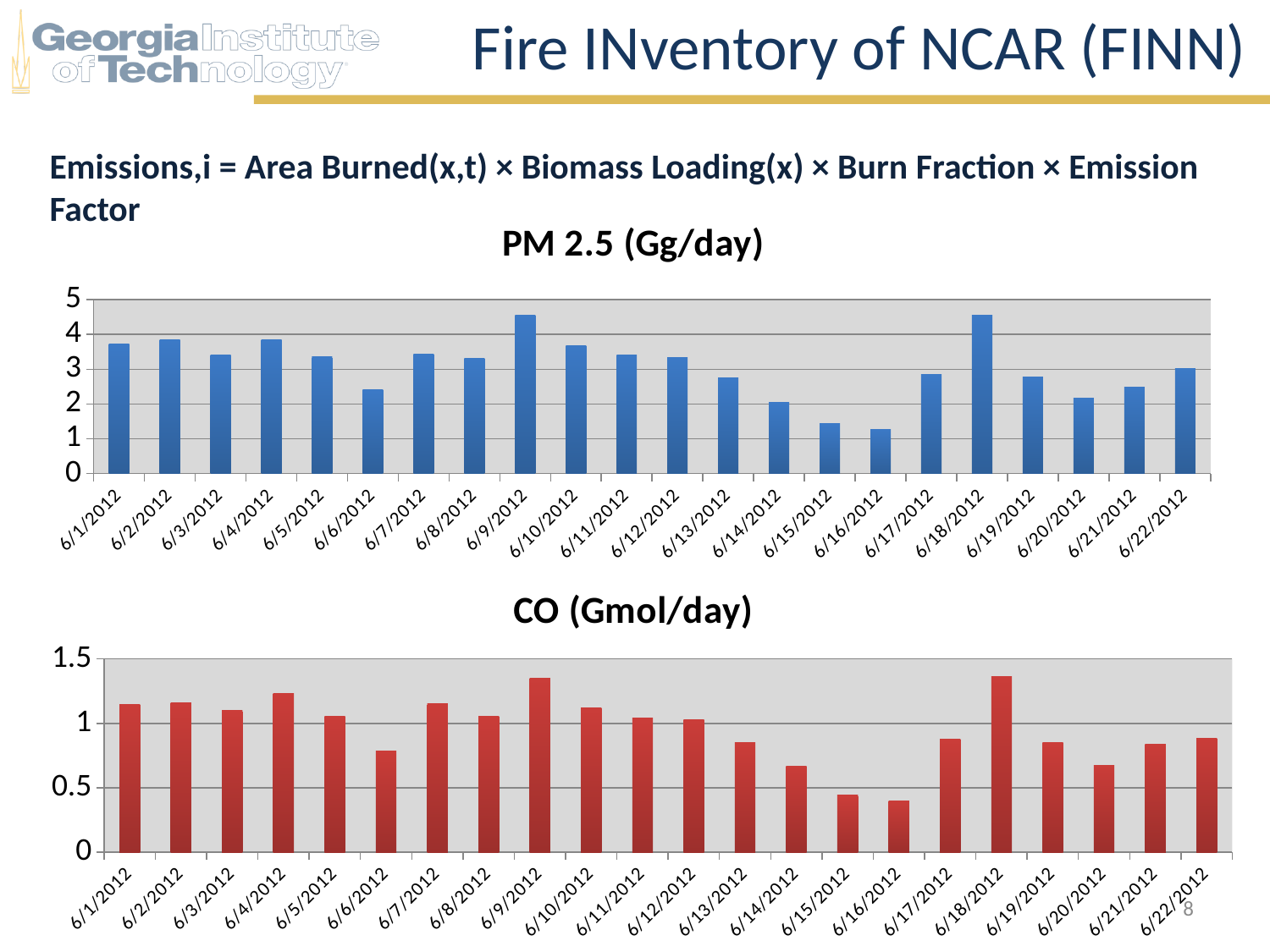
In the CO (Gmol/day) chart, do the values rise or fall from 6/9/2012 to 6/16/2012? fall In the PM 2.5 (Gg/day) chart, what kind of chart is used? bar chart In the CO (Gmol/day) chart, which is larger, the value for 6/1/2012 or the value for 6/16/2012? 6/1/2012 In the CO (Gmol/day) chart, how many dates are plotted along the x axis? 22 In the PM 2.5 (Gg/day) chart, is the value for 6/13/2012 greater or less than 3? less In the PM 2.5 (Gg/day) chart, which date has the lowest value? 6/16/2012 What colour are the bars in the CO (Gmol/day) chart? red In the PM 2.5 (Gg/day) chart, is the value for 6/9/2012 greater or less than 4? greater In the PM 2.5 (Gg/day) chart, is the value for 6/16/2012 greater or less than 2? less In the PM 2.5 (Gg/day) chart, which is larger, the value for 6/9/2012 or the value for 6/14/2012? 6/9/2012